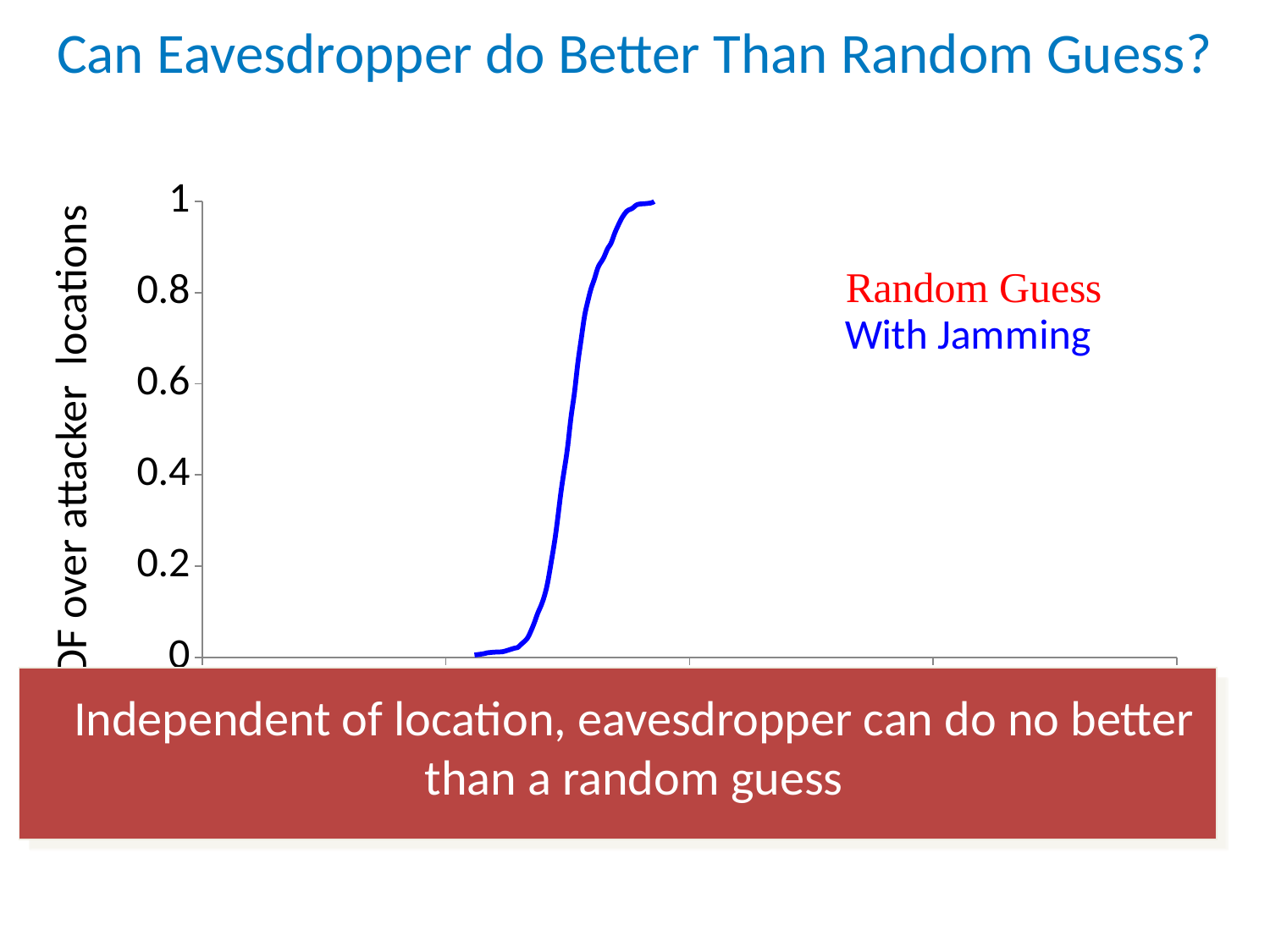
What is the highest tick value shown on the y axis? 1 Does the blue 'With Jamming' curve rise or fall as it moves from left to right along the x axis? rise What is the lowest tick value shown on the y axis? 0 How many series does the legend list? 2 What colour is the 'Random Guess' entry in the legend? red Which series is drawn in blue according to the legend? With Jamming What is the maximum value reached by the 'With Jamming' curve at the right end? 1 What kind of chart is shown on the slide? line chart